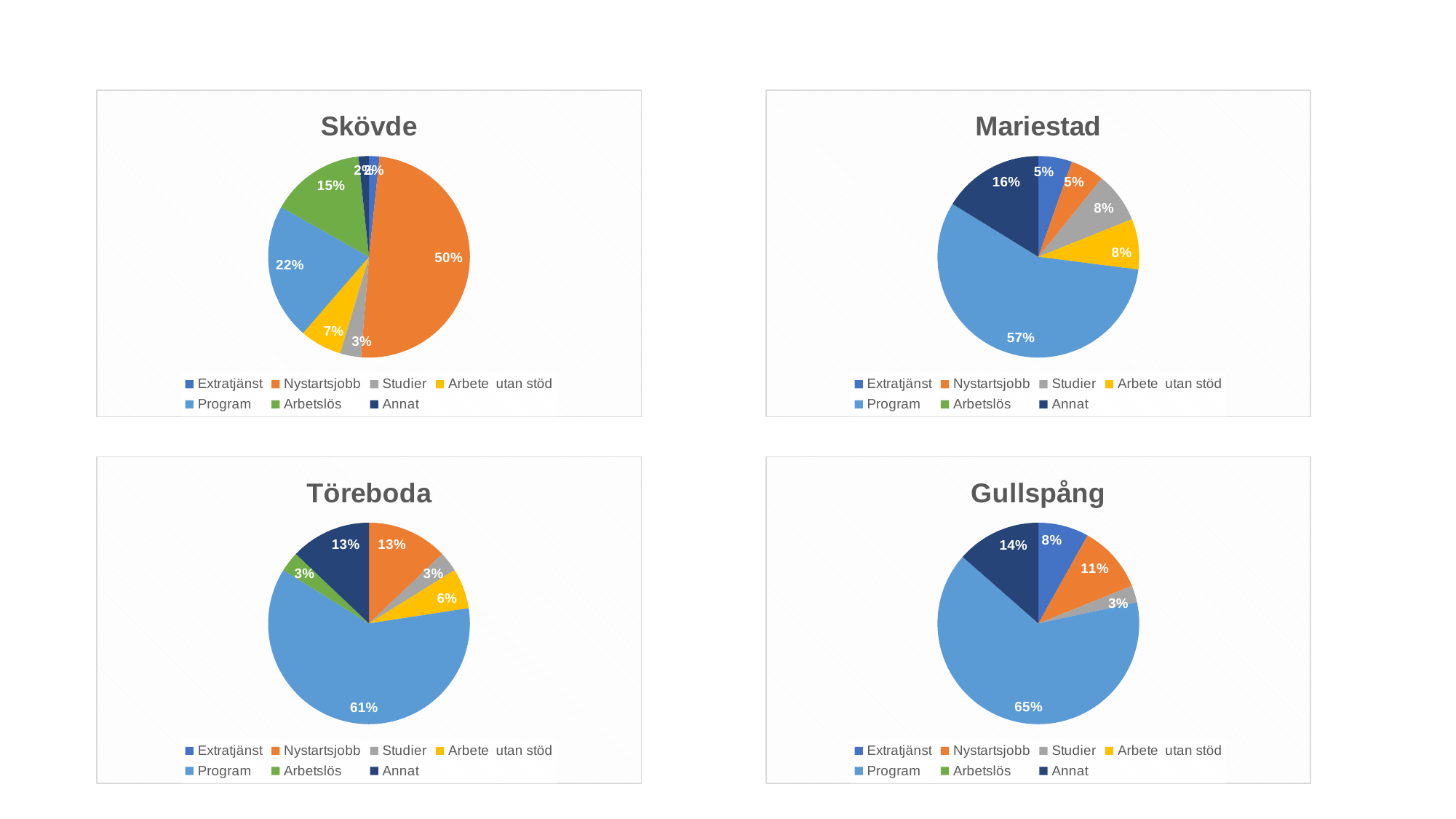
In the Gullspång chart, which category has the largest share? Program In the Töreboda chart, what share does Program have? 61% In the Töreboda chart, which is larger, Nystartsjobb or Arbete utan stöd? Nystartsjobb In the Skövde chart, what share does Nystartsjobb have? 50% What type of chart is the Gullspång chart? Pie chart In the Mariestad chart, what is the difference between the Program share and the Annat share? 41% In the Skövde chart, which category has the largest share? Nystartsjobb In the Gullspång chart, what share does Nystartsjobb have? 11% In the Skövde chart, what share does Program have? 22% How many entries does the legend of the Töreboda chart list? 7 In the Mariestad chart, what share does Annat have? 16% In the Mariestad chart, what share does Program have? 57%